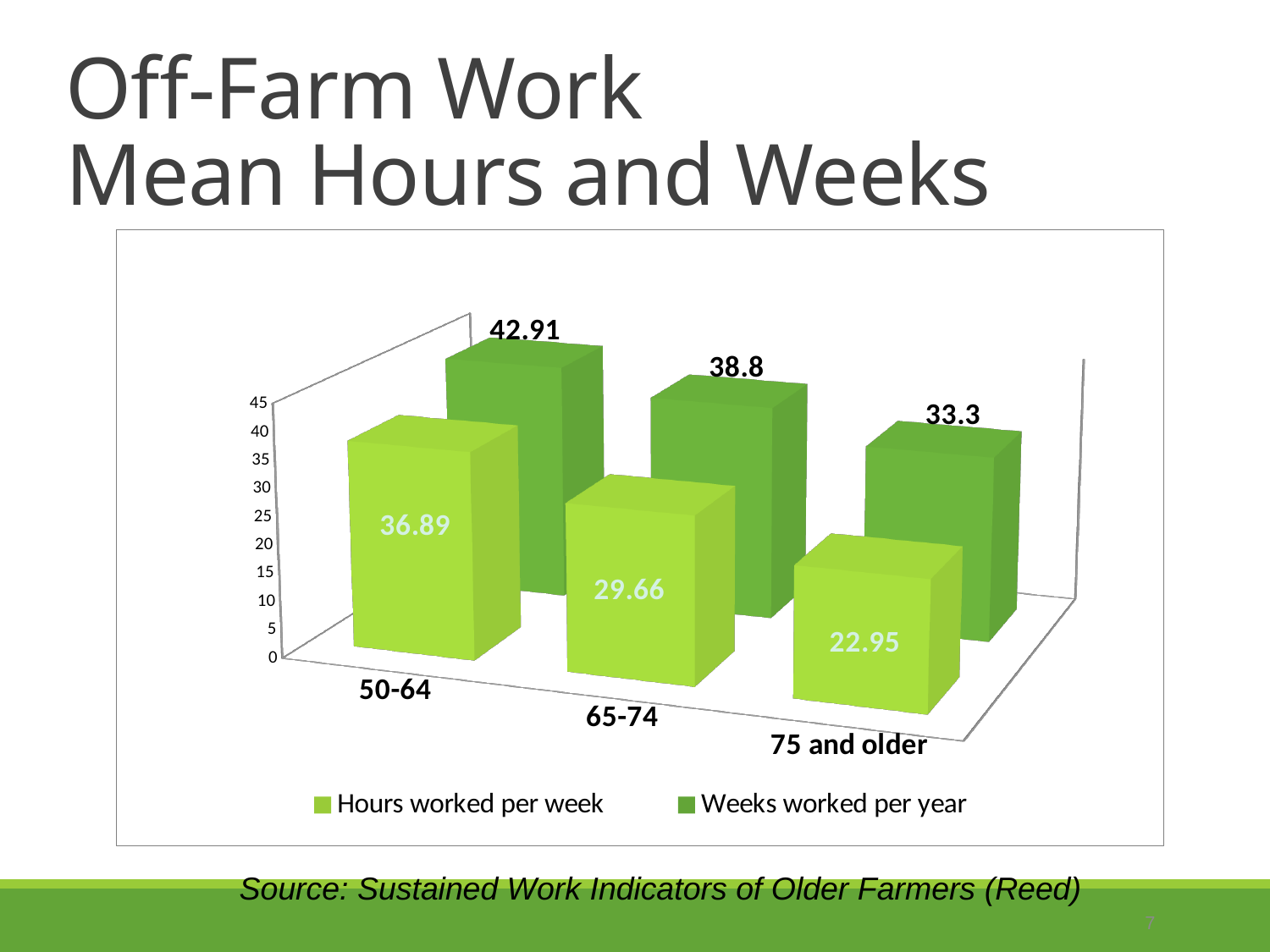
What is the mean hours worked per week for the 50-64 age group? 36.89 What is the title of the slide containing the chart? Off-Farm Work Mean Hours and Weeks Do the hours worked per week rise or fall as the age groups get older? Fall What is the mean weeks worked per year for the 65-74 age group? 38.8 What kind of chart is shown on the slide? Bar chart What is the mean hours worked per week for the 75 and older age group? 22.95 Which is larger for the 65-74 age group: hours worked per week or weeks worked per year? Weeks worked per year Which age group has the highest mean weeks worked per year? 50-64 Which age group has the lowest mean hours worked per week? 75 and older How many age groups are shown on the chart? 3 What is the difference in weeks worked per year between the 50-64 and 75 and older age groups? 9.61 How many series does the legend list? 2